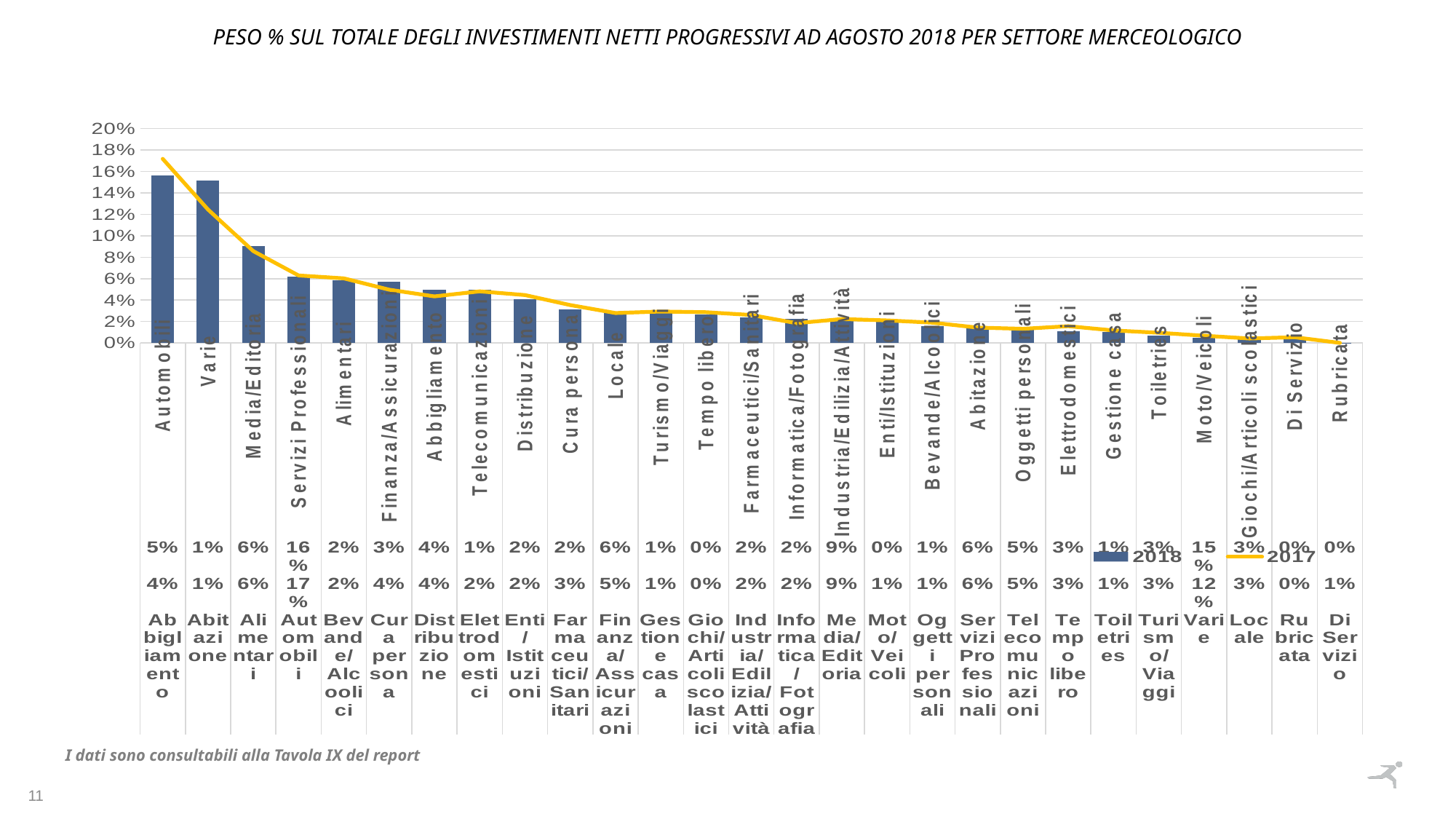
What is the 2017 value for Automobili? 17% What is the difference between the 2017 and 2018 values for Varie? 3 percentage points What is the 2018 value for Media/Editoria? 9% Which is larger for Finanza/Assicurazioni, the 2018 value or the 2017 value? 2018 Which sector has the highest 2018 value? Automobili How many sectors are shown on the x axis? 27 What is the 2017 value for Varie? 12% How many series does the legend list? 2 What is the 2018 value for Varie? 15% Do the 2018 bars rise or fall from left to right along the x axis? fall What is the 2018 value for Automobili? 16% What is the 2018 value for Abbigliamento? 5%